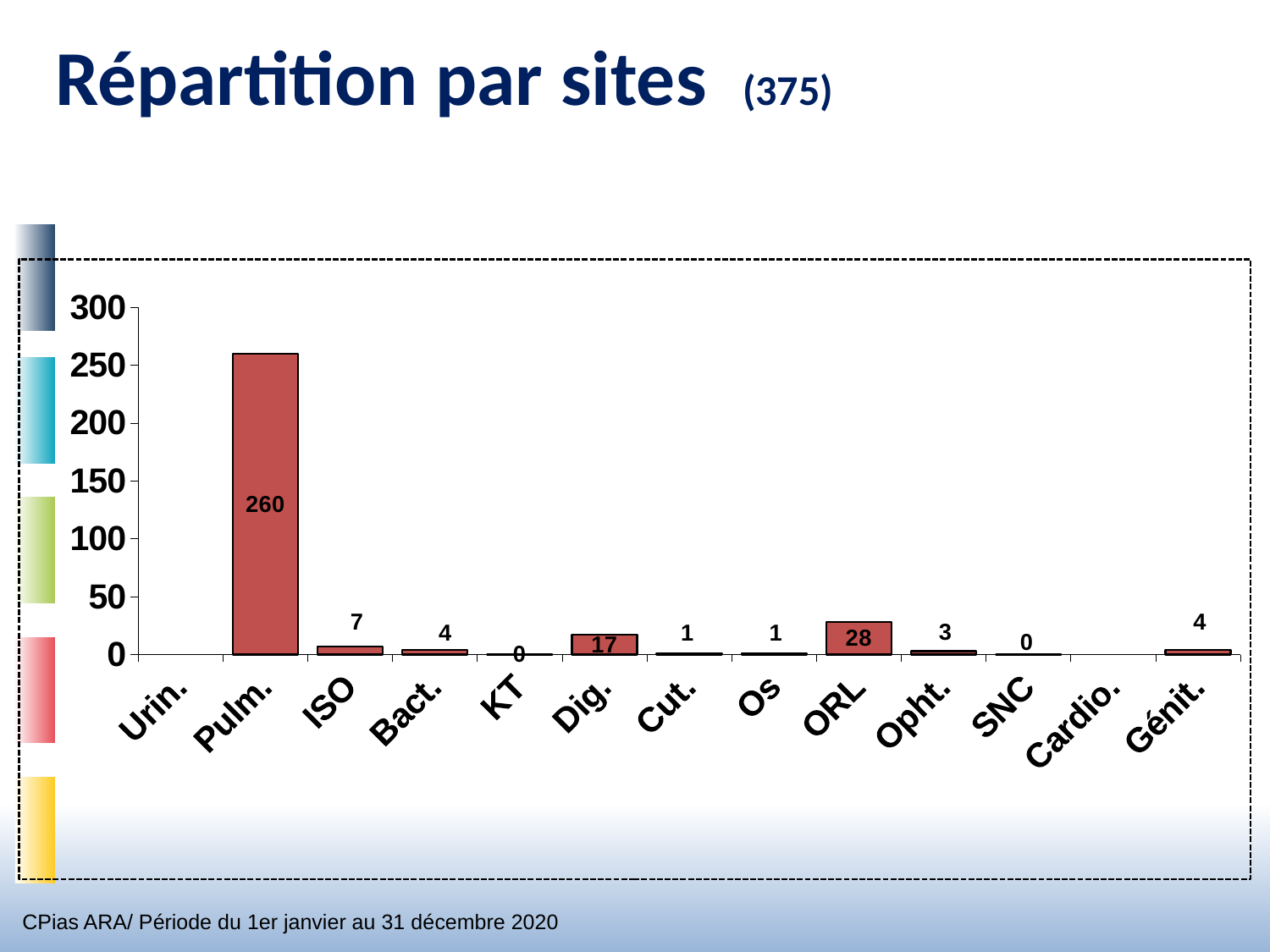
What is the value for Dig.? 17 What kind of chart is shown on the slide? bar chart What is the value for Pulm.? 260 What is the value for Opht.? 3 What is the difference between the values for ORL and Dig.? 11 What is the value for ORL? 28 What is the value for ISO? 7 What is the difference between the values for Pulm. and ORL? 232 Which is larger, the value for ISO or the value for Bact.? ISO Which category has the highest value? Pulm. How many categories are shown on the x axis? 13 Is the value for Pulm. greater or less than 250? greater